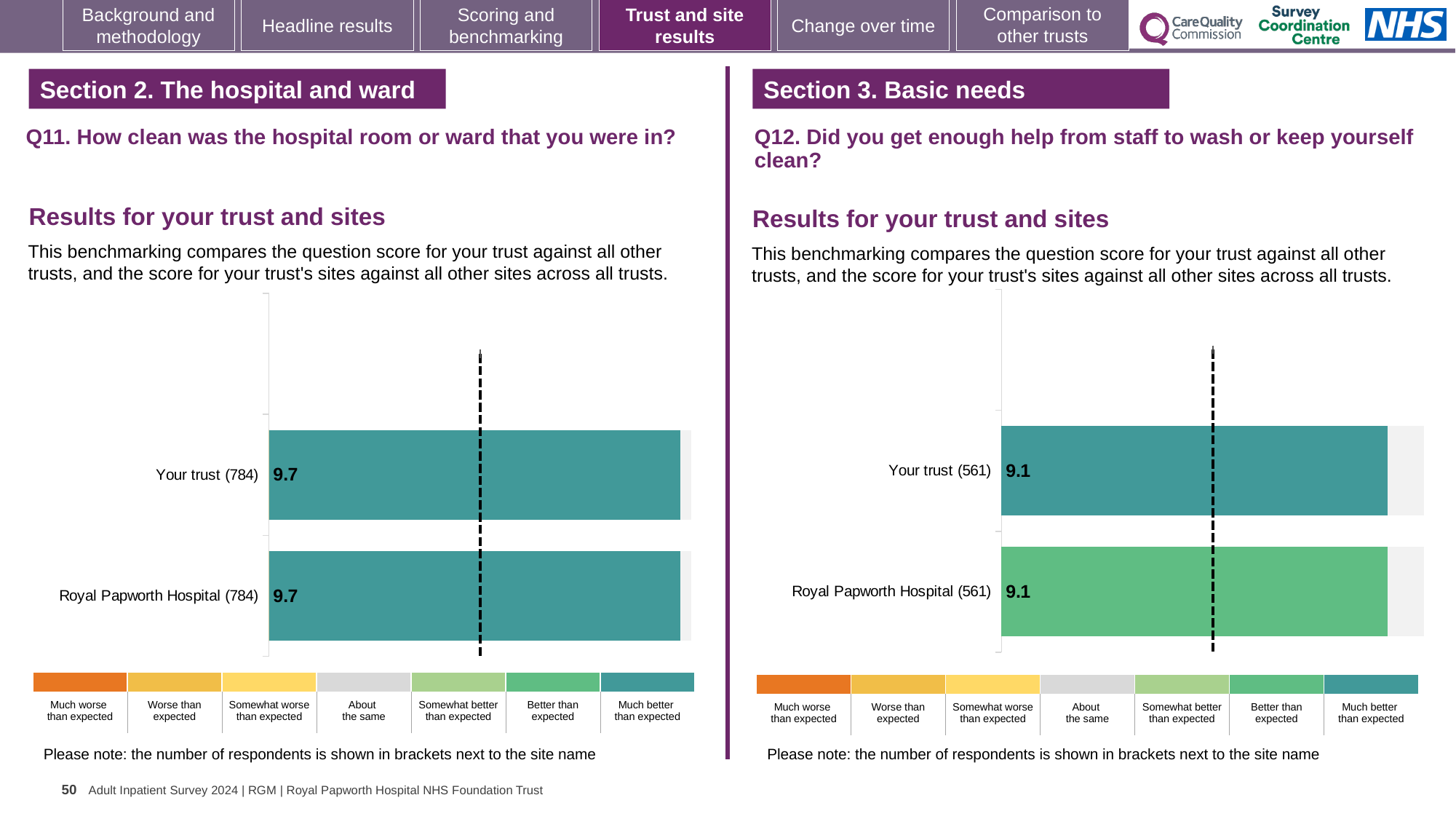
What kind of chart is used for the Q11 results (left)? Bar chart How many bars are plotted in the Q11 chart (left)? 2 In the Q12 chart (right), what is the difference between the score for Your trust and the score for Royal Papworth Hospital? 0 Is the score for Your trust in the Q11 chart (left) higher or lower than the score for Your trust in the Q12 chart (right)? Higher In the Q11 chart (left), what is the difference between the score for Your trust and the score for Royal Papworth Hospital? 0 In the Q12 chart (right), what is the score for Royal Papworth Hospital (561)? 9.1 How many bars are plotted in the Q12 chart (right)? 2 How many respondents are shown in brackets for Your trust in the Q12 chart (right)? 561 In the Q12 chart (right), which benchmark category does the colour of the Royal Papworth Hospital bar correspond to in the legend? Better than expected In the Q12 chart (right), what is the score for Your trust (561)? 9.1 In the Q11 chart (left), what is the score for Your trust (784)? 9.7 In the Q11 chart (left), what is the score for Royal Papworth Hospital (784)? 9.7